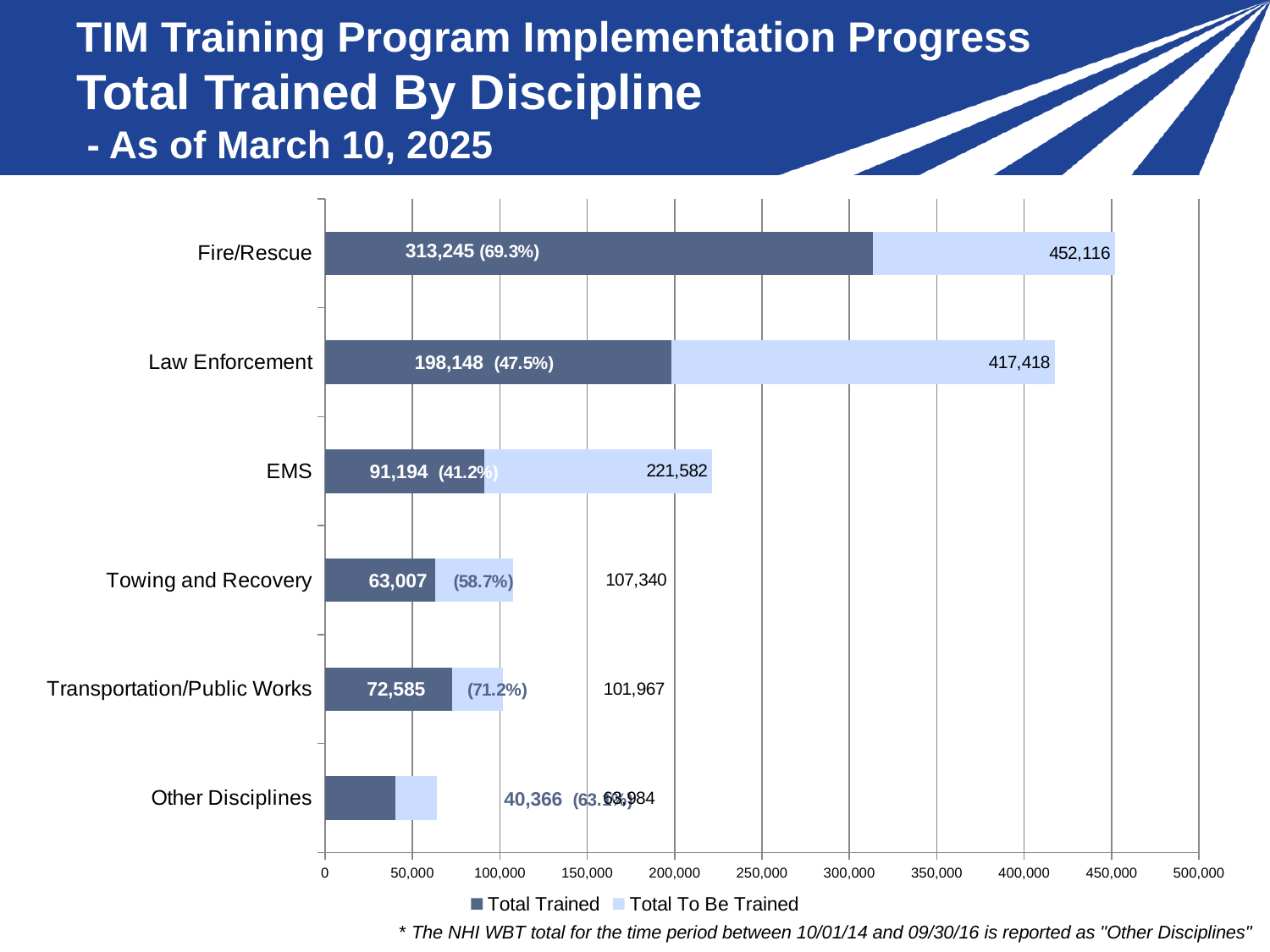
What is the difference between the Total Trained values for Fire/Rescue and Law Enforcement? 115,097 What value is printed at the end of the Law Enforcement bar? 417,418 Which discipline has the highest Total Trained value? Fire/Rescue What percentage is shown for Towing and Recovery? 58.7% What kind of chart is shown on the slide? bar chart What percentage is shown for Law Enforcement? 47.5% What is the Total Trained value for Fire/Rescue? 313,245 How many disciplines are listed on the chart? 6 Which discipline has the lowest Total Trained value? Other Disciplines Which has a larger Total Trained value, Towing and Recovery or Transportation/Public Works? Transportation/Public Works What is the Total Trained value for EMS? 91,194 How many series does the legend list? 2